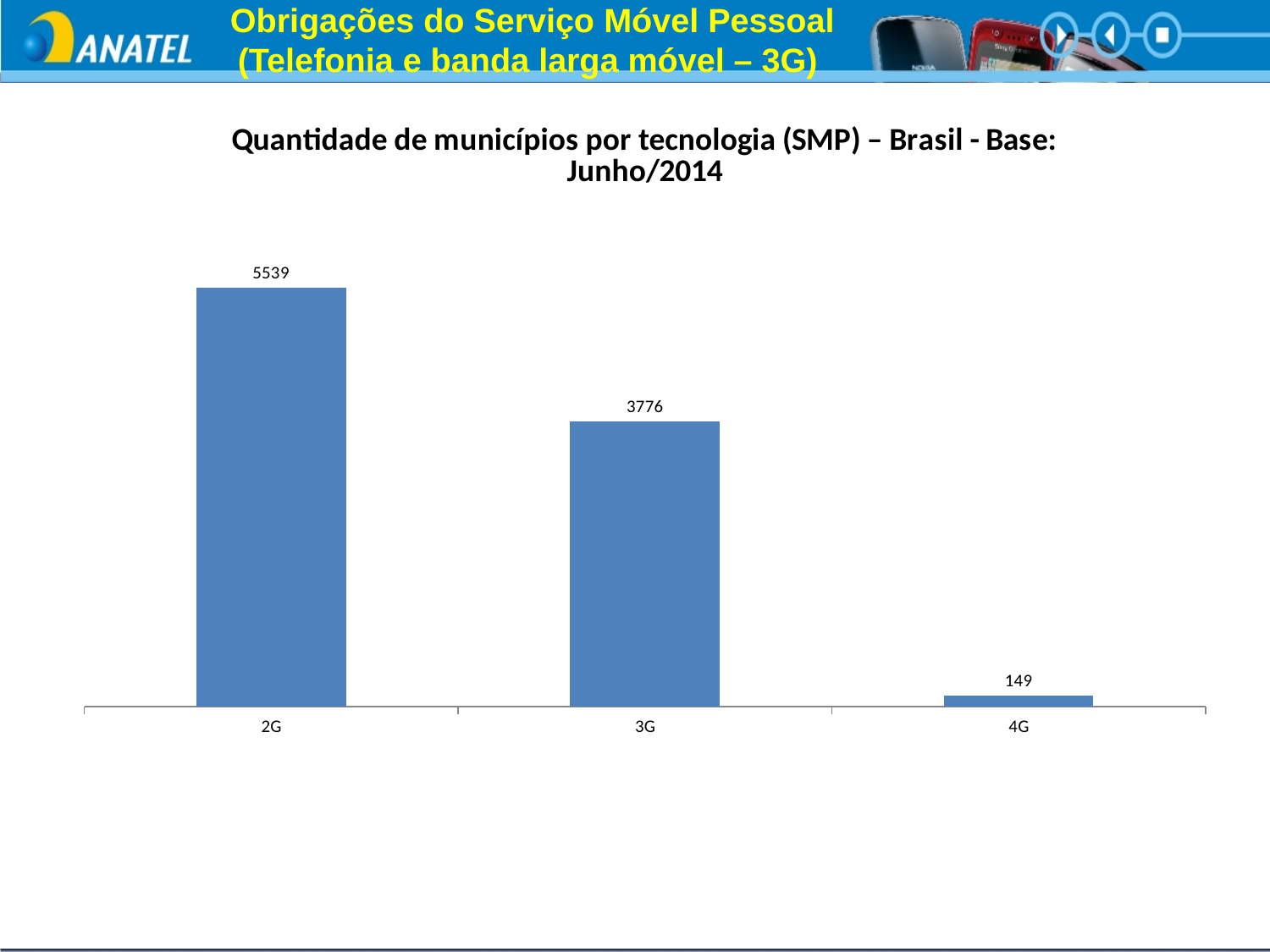
How many municipalities have 2G technology according to the chart? 5539 What is the title of the chart? Quantidade de municípios por tecnologia (SMP) – Brasil - Base: Junho/2014 What is the difference between the values for 2G and 3G? 1763 Which technology has the lowest number of municipalities? 4G What is the value shown for 3G? 3776 Which technology has the highest number of municipalities? 2G What is the difference between the values for 3G and 4G? 3627 What kind of chart is shown on the slide? Bar chart What is the value shown for 4G? 149 Do the values rise or fall moving from 2G to 4G along the x axis? Fall How many technology categories are shown on the x axis? 3 Which has a larger value, 3G or 4G? 3G